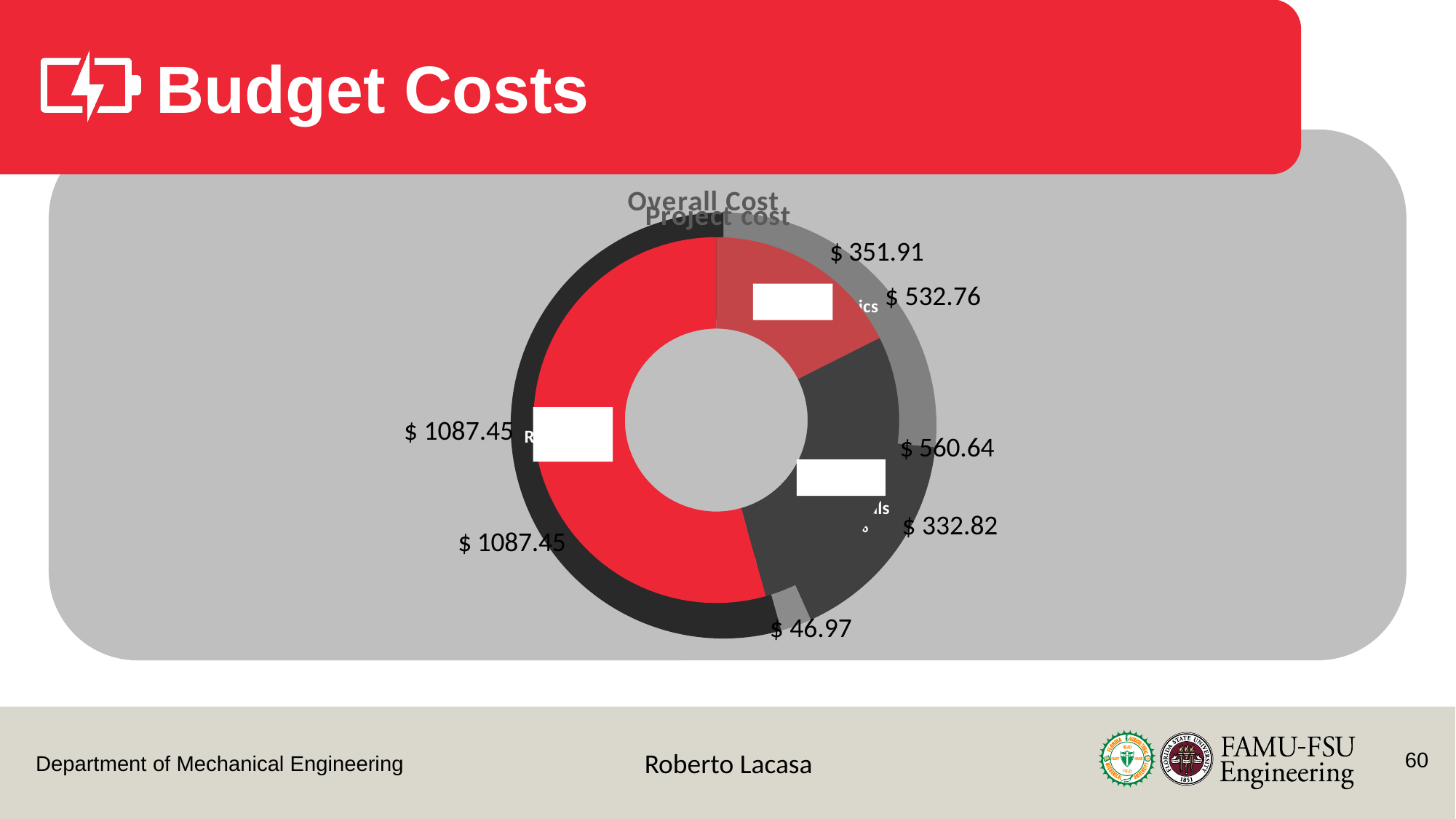
What is the value of the data label printed at the bottom of the chart, next to the small grey slice? $ 46.97 What is the title printed at the top of the chart in the larger grey text? Overall Cost What kind of chart is shown on the slide? Doughnut (pie) chart What value is printed on the left side of the chart next to the large red slice? $ 1087.45 What is the smallest dollar value printed as a data label on the chart? $ 46.97 What is the value of the data label printed at the top right of the chart, above $ 532.76? $ 351.91 What is the largest dollar value printed as a data label on the chart? $ 1087.45 What is the second, overlapping title printed just below 'Overall Cost'? Project cost Which printed data label is larger, $ 351.91 or $ 332.82? $ 351.91 What is the difference between the largest printed data label ($ 1087.45) and the smallest printed data label ($ 46.97)? $ 1040.48 Which printed data label is larger, $ 560.64 or $ 532.76? $ 560.64